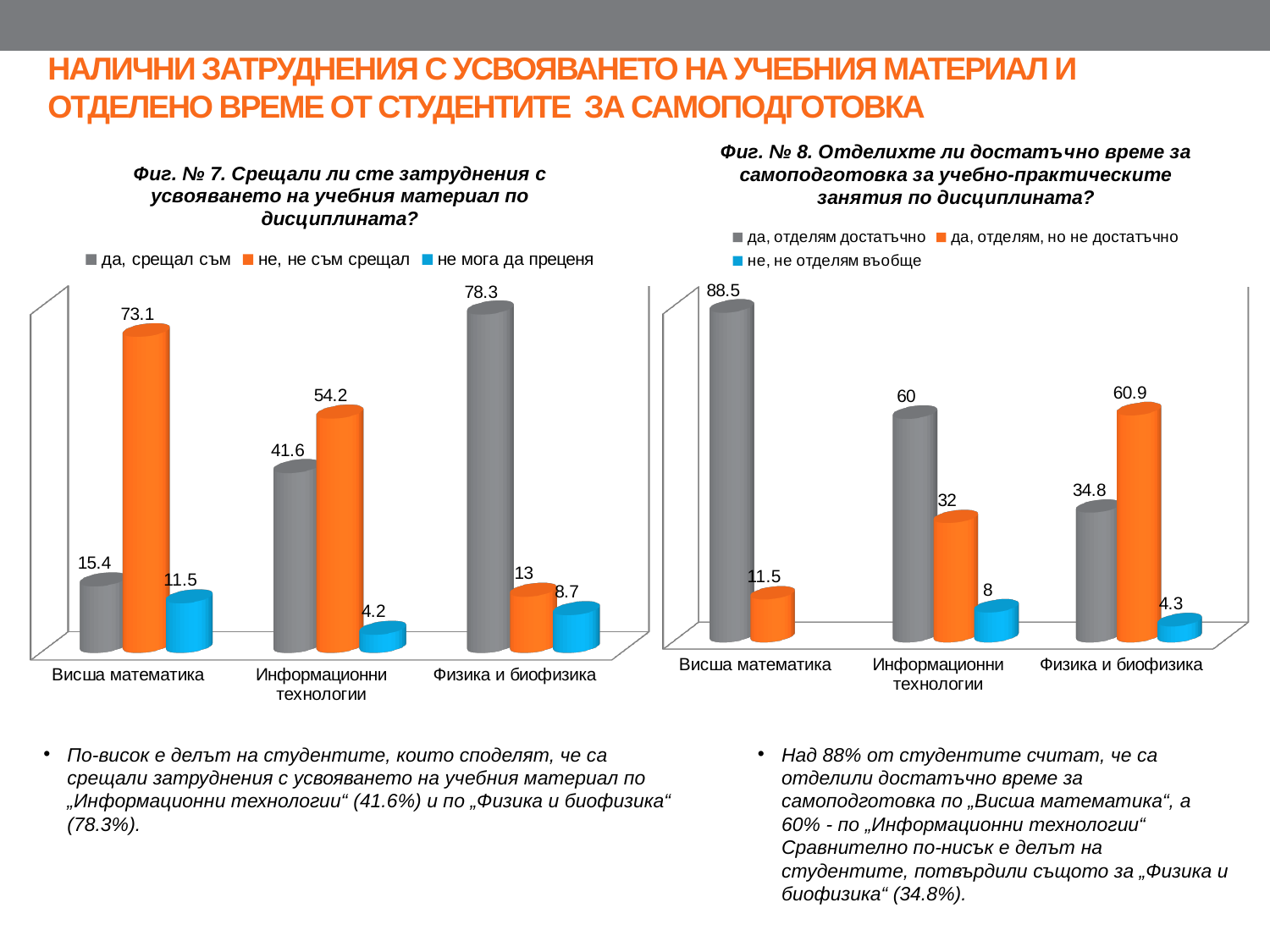
In the chart titled "Фиг. № 8", which is larger for "Информационни технологии": "да, отделям достатъчно" or "да, отделям, но не достатъчно"? да, отделям достатъчно In the chart titled "Фиг. № 8", what is the difference between the "не, не отделям въобще" values for "Информационни технологии" and "Физика и биофизика"? 3.7 In the chart titled "Фиг. № 7", what is the value for "не, не съм срещал" for "Висша математика"? 73.1 In the chart titled "Фиг. № 8", what is the value for "да, отделям, но не достатъчно" for "Физика и биофизика"? 60.9 In the chart titled "Фиг. № 8", what is the value for "да, отделям достатъчно" for "Висша математика"? 88.5 In the chart titled "Фиг. № 8", which category has the highest value for "да, отделям достатъчно"? Висша математика What kind of chart is the chart titled "Фиг. № 8"? Bar chart How many categories are shown on the x axis of the chart titled "Фиг. № 7"? 3 In the chart titled "Фиг. № 7", which category has the lowest value for "не мога да преценя"? Информационни технологии In the chart titled "Фиг. № 7", what is the value for "да, срещал съм" for "Физика и биофизика"? 78.3 In the chart titled "Фиг. № 7", how many series does the legend list? 3 In the chart titled "Фиг. № 7", what is the difference between the "не, не съм срещал" values for "Висша математика" and "Информационни технологии"? 18.9